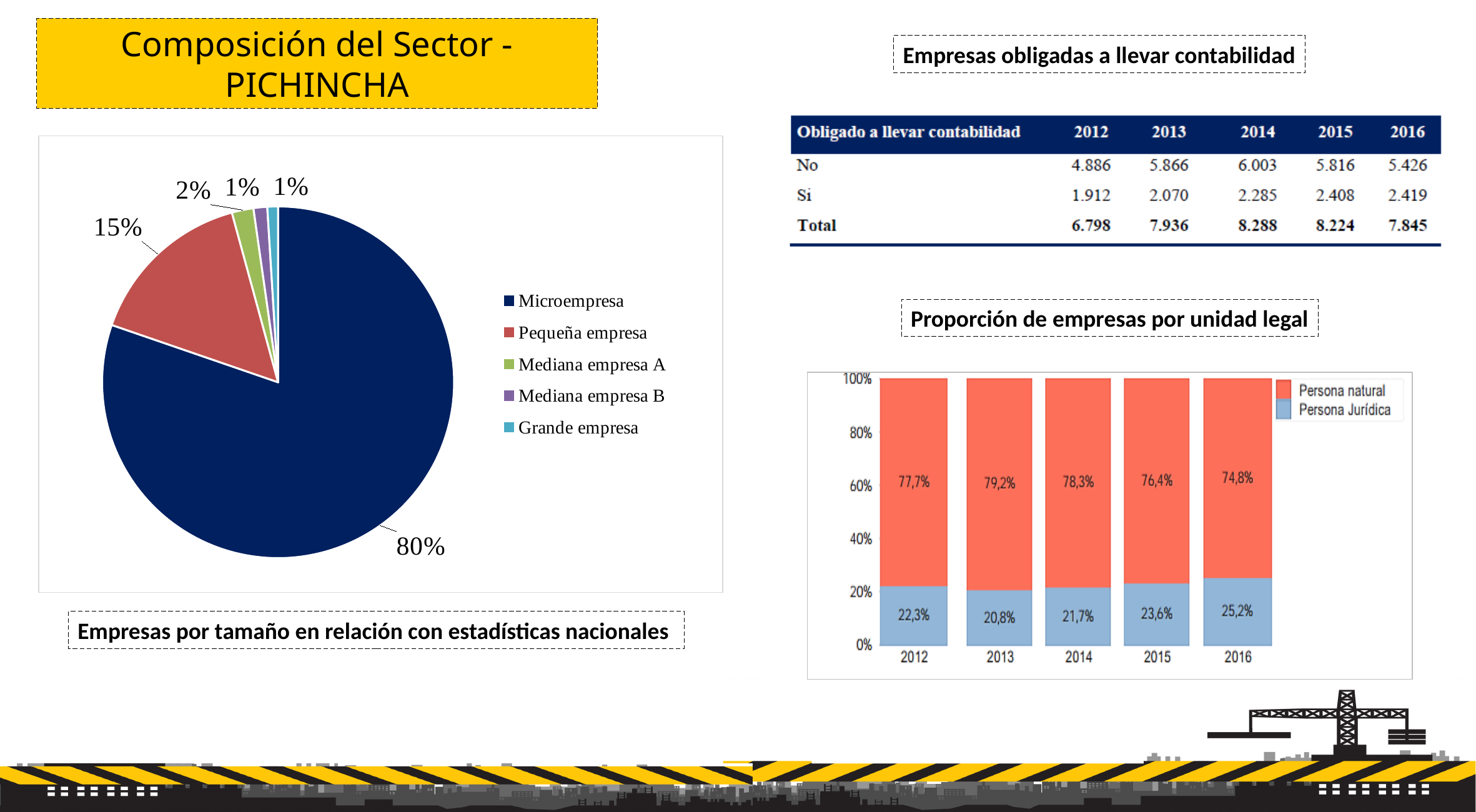
How many series does the legend of the chart 'Proporción de empresas por unidad legal' list? 2 What kind of chart is the chart titled 'Empresas por tamaño en relación con estadísticas nacionales'? pie chart How many categories does the pie chart 'Empresas por tamaño en relación con estadísticas nacionales' show? 5 In the chart 'Proporción de empresas por unidad legal', what is the value for Persona natural in 2013? 79,2% In the pie chart 'Empresas por tamaño en relación con estadísticas nacionales', what share does Microempresa have? 80% What kind of chart is the chart titled 'Proporción de empresas por unidad legal'? stacked bar chart In the pie chart 'Empresas por tamaño en relación con estadísticas nacionales', what is the value for Pequeña empresa? 15% In the pie chart 'Empresas por tamaño en relación con estadísticas nacionales', what is the difference between the Microempresa and Pequeña empresa shares? 65% In the pie chart 'Empresas por tamaño en relación con estadísticas nacionales', which category has the largest slice? Microempresa In the chart 'Proporción de empresas por unidad legal', what is the value for Persona Jurídica in 2016? 25,2% In the chart 'Proporción de empresas por unidad legal', does the Persona Jurídica value rise or fall from 2013 to 2016? rise In the chart 'Proporción de empresas por unidad legal', which year has the lowest value for Persona Jurídica? 2013